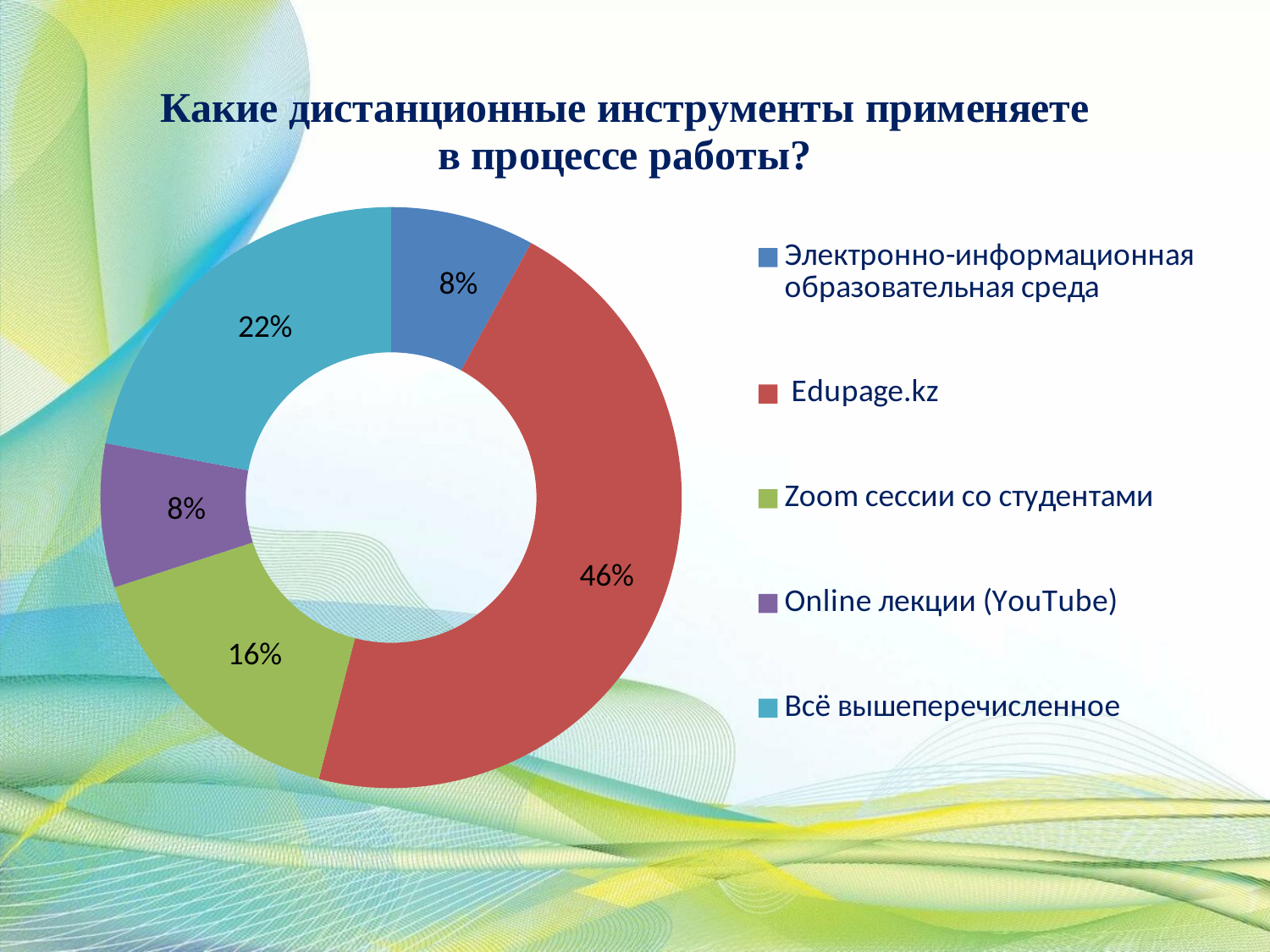
What percentage is shown for Всё вышеперечисленное? 22% What percentage is shown for Электронно-информационная образовательная среда? 8% What kind of chart is shown on the slide? doughnut chart What is the difference in percentage points between Zoom сессии со студентами and Online лекции (YouTube)? 8 What is the difference in percentage points between Edupage.kz and Всё вышеперечисленное? 24 What share of the chart does Edupage.kz account for? 46% What colour is the Edupage.kz segment in the chart? red What percentage is shown for Zoom сессии со студентами? 16% What percentage is shown for Online лекции (YouTube)? 8% Which category has the largest share of the chart? Edupage.kz How many categories does the chart show? 5 Which is larger: the share for Всё вышеперечисленное or the share for Zoom сессии со студентами? Всё вышеперечисленное